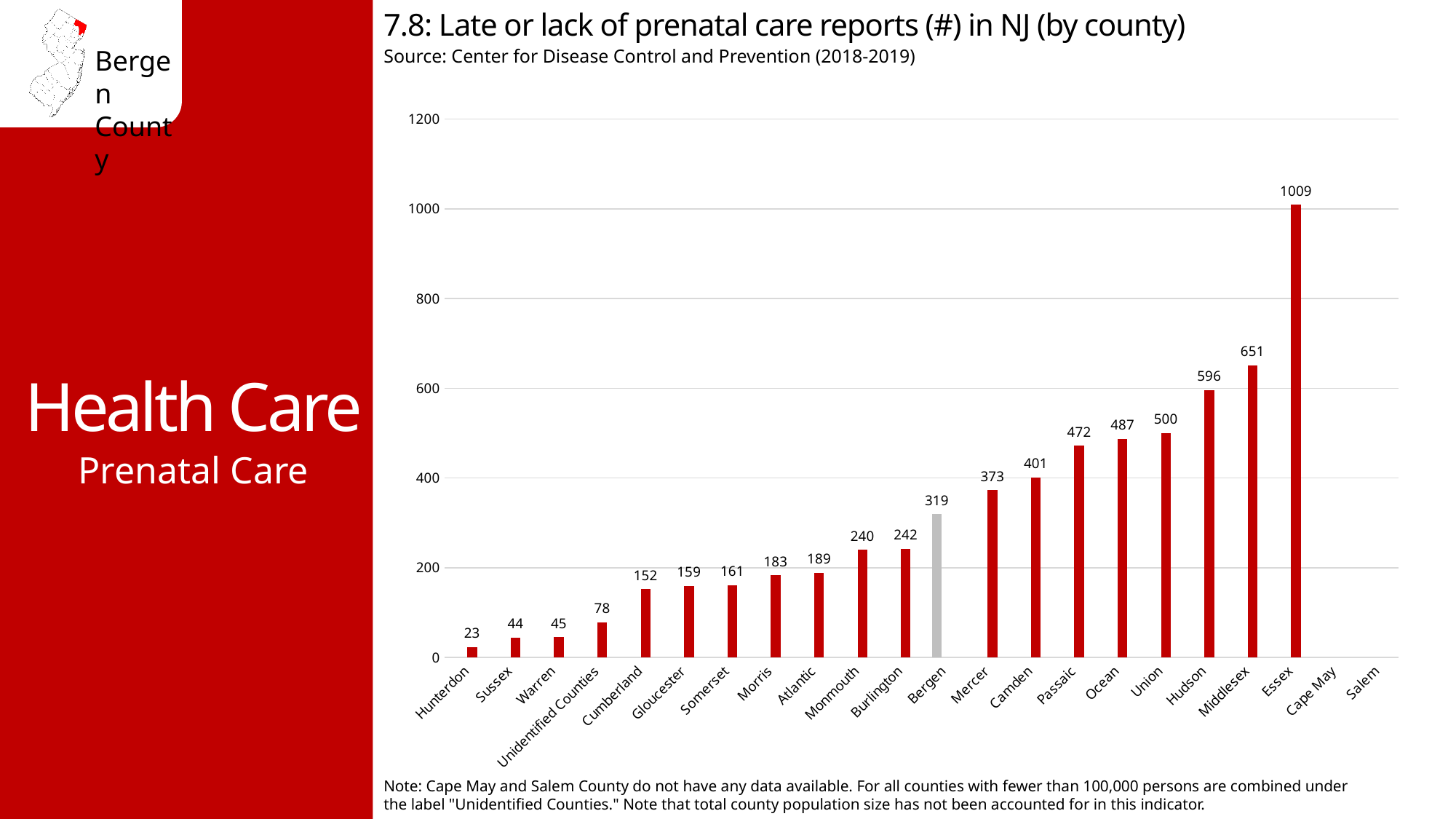
What kind of chart is shown on the slide? Bar chart What is the difference between the values for Essex and Middlesex? 358 Which county has the highest number of late or lack of prenatal care reports? Essex Is the value for Passaic greater or less than 400? greater How many county labels are shown on the x axis? 22 Which bar is coloured grey instead of red? Bergen What is the value for Bergen? 319 Which county with a plotted bar has the lowest value? Hunterdon What is the value for Unidentified Counties? 78 Which is larger, the value for Hudson or the value for Union? Hudson What is the difference between the values for Bergen and Mercer? 54 What is the value for Essex? 1009